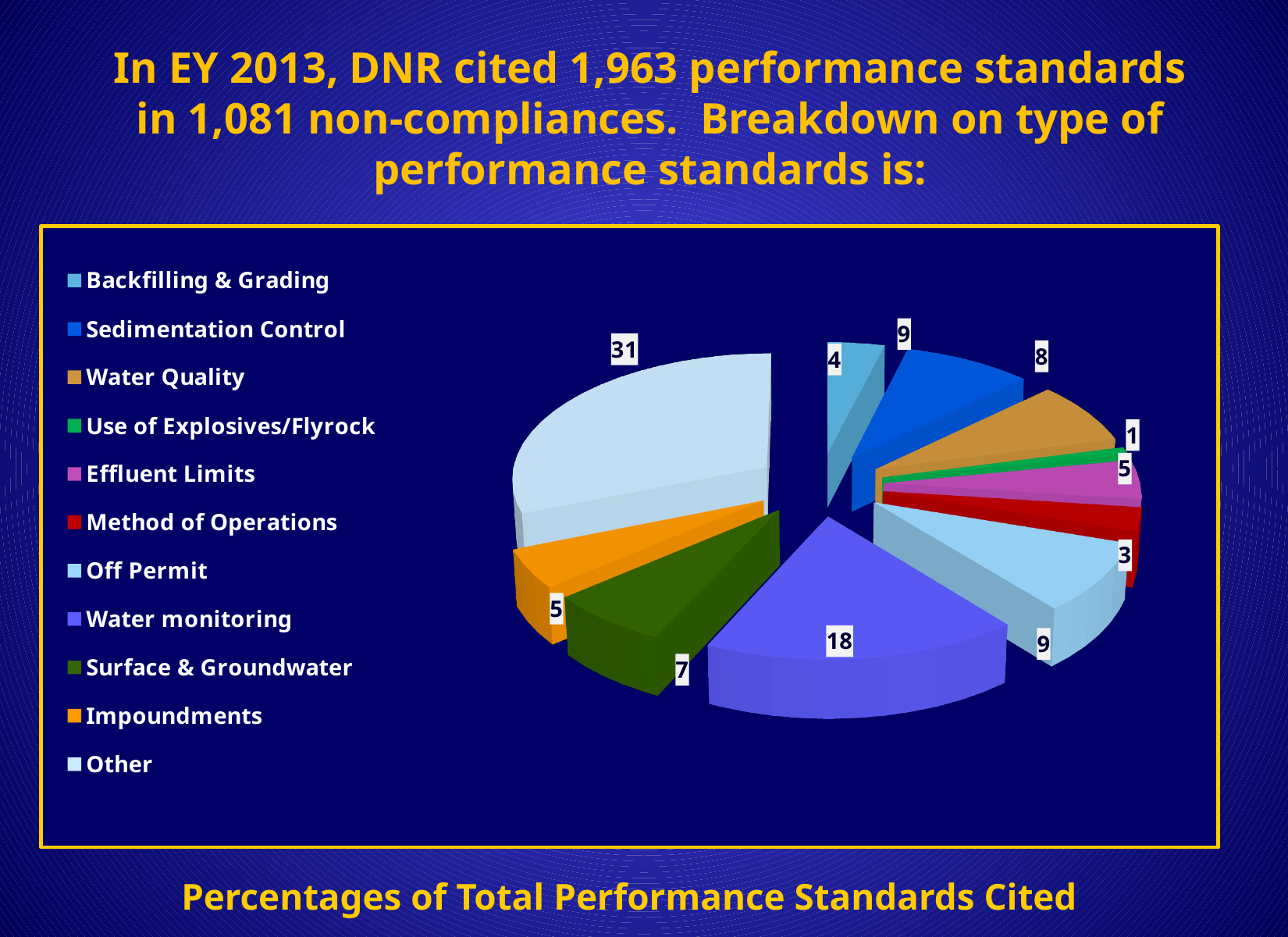
What is the difference between the values for Other and Water monitoring? 13 What value is shown for the Use of Explosives/Flyrock slice? 1 Which is larger, the value for Sedimentation Control or the value for Method of Operations? Sedimentation Control What value is shown for the Other slice? 31 Which category has the largest slice of the pie? Other What type of chart is shown on the slide? pie chart What is the difference between the values for Surface & Groundwater and Impoundments? 2 What value is shown for the Water Quality slice? 8 What is the caption shown below the chart? Percentages of Total Performance Standards Cited How many categories does the legend list? 11 What value is shown for the Water monitoring slice? 18 Which category has the smallest slice of the pie? Use of Explosives/Flyrock